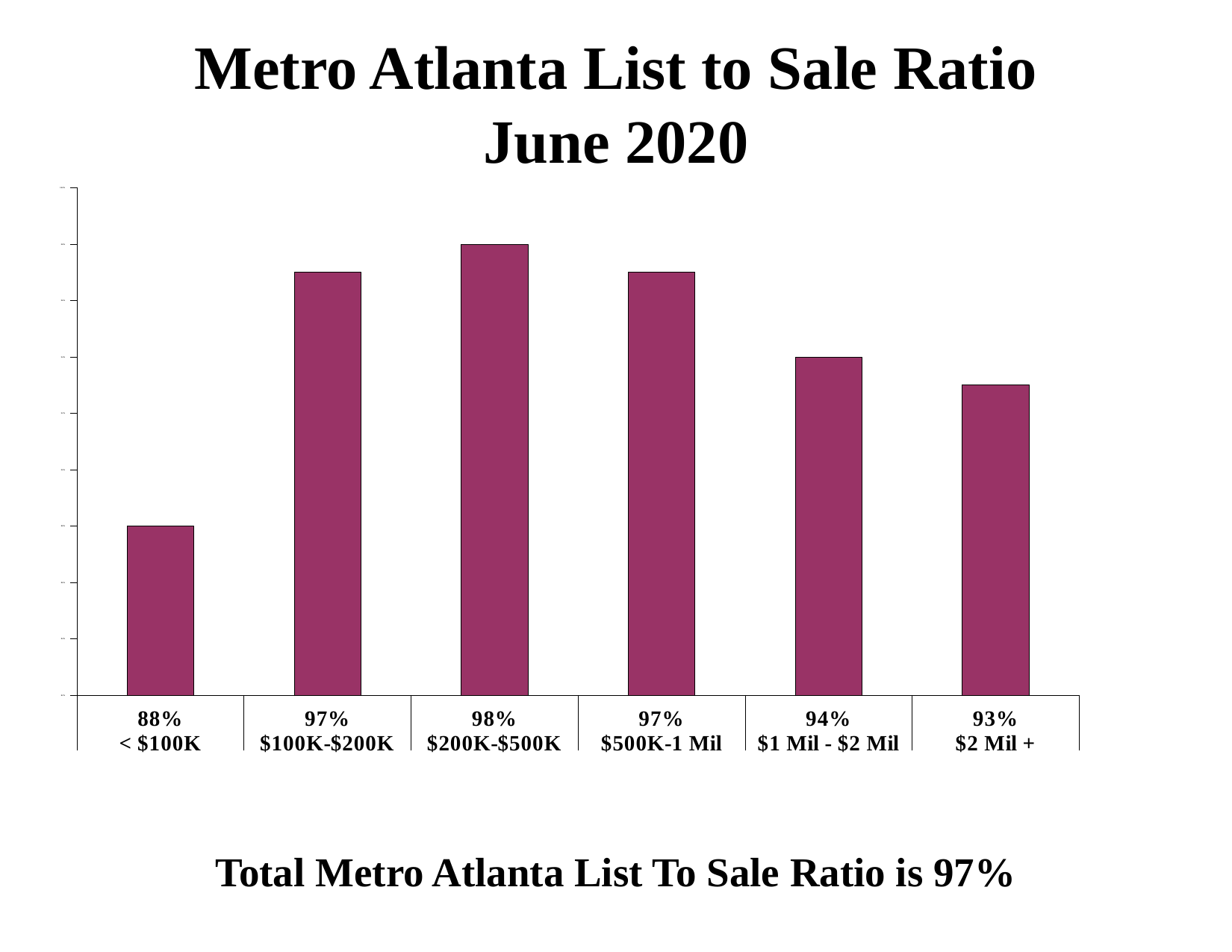
What is the list to sale ratio for the $200K-$500K price range? 98% What is the difference between the list to sale ratio for $200K-$500K and for < $100K? 10% Which has a higher list to sale ratio, $100K-$200K or $1 Mil - $2 Mil? $100K-$200K Which price range has the lowest list to sale ratio? < $100K What is the list to sale ratio for the < $100K price range? 88% How many price range categories are shown in the chart? 6 Which price range has the highest list to sale ratio? $200K-$500K What is the list to sale ratio for the $2 Mil + price range? 93% What is the difference between the list to sale ratio for $1 Mil - $2 Mil and for $2 Mil +? 1% What is the list to sale ratio for the $1 Mil - $2 Mil price range? 94% What type of chart is shown on the slide? Bar chart What is the title of the chart? Metro Atlanta List to Sale Ratio June 2020